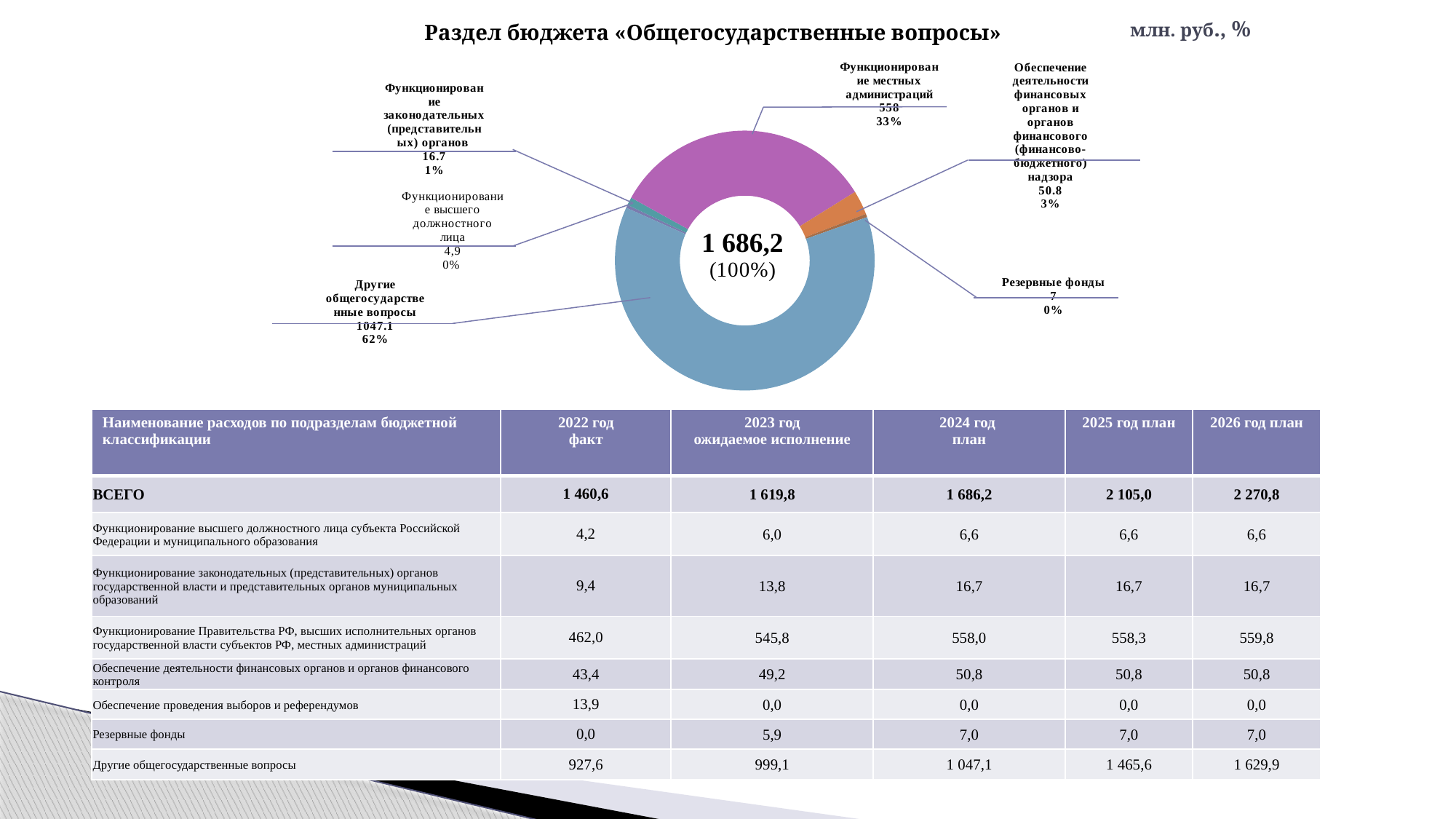
What type of chart is shown on the slide? Pie (donut) chart Which category has the largest slice in the donut chart? Другие общегосударственные вопросы What value is shown for «Другие общегосударственные вопросы» in the donut chart? 1047.1 What is the title of the chart on the slide? Раздел бюджета «Общегосударственные вопросы» What value is shown for «Обеспечение деятельности финансовых органов и органов финансового (финансово-бюджетного) надзора» in the donut chart? 50.8 What share of the donut chart does «Функционирование законодательных (представительных) органов» represent? 1% What value is shown for «Резервные фонды» in the donut chart? 7 Which category has the smallest value in the donut chart? Функционирование высшего должностного лица Which is larger in the donut chart: «Функционирование местных администраций» or «Обеспечение деятельности финансовых органов»? Функционирование местных администраций What share of the donut chart does «Функционирование местных администраций» represent? 33% What total value is shown in the centre of the donut chart? 1 686,2 How many slices (categories) does the donut chart have? 6